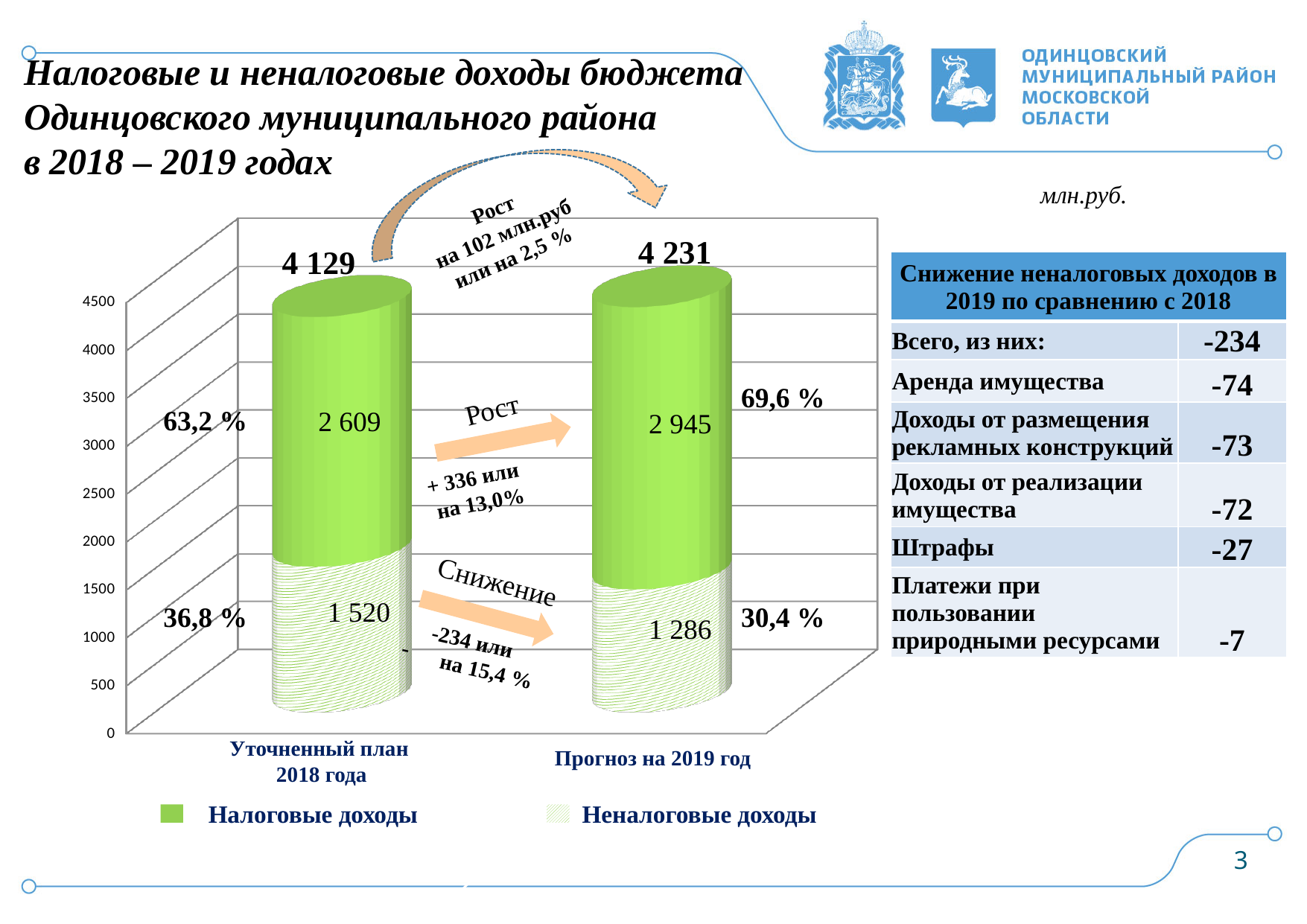
How many series does the chart legend list? 2 What is the value of Налоговые доходы for Прогноз на 2019 год? 2 945 What is the difference between Неналоговые доходы in Уточненный план 2018 года and in Прогноз на 2019 год? 234 What kind of chart is shown on the slide? Stacked bar chart Which is larger: Неналоговые доходы in Уточненный план 2018 года or in Прогноз на 2019 год? Уточненный план 2018 года What is the value of Неналоговые доходы for Прогноз на 2019 год? 1 286 What is the difference between Налоговые доходы in Прогноз на 2019 год and in Уточненный план 2018 года? 336 What is the value of Налоговые доходы for Уточненный план 2018 года? 2 609 What is the total of the stacked bar for Прогноз на 2019 год? 4 231 Do the Налоговые доходы values rise or fall from Уточненный план 2018 года to Прогноз на 2019 год? Rise How many categories are shown on the x axis of the chart? 2 What is the total of the stacked bar for Уточненный план 2018 года? 4 129